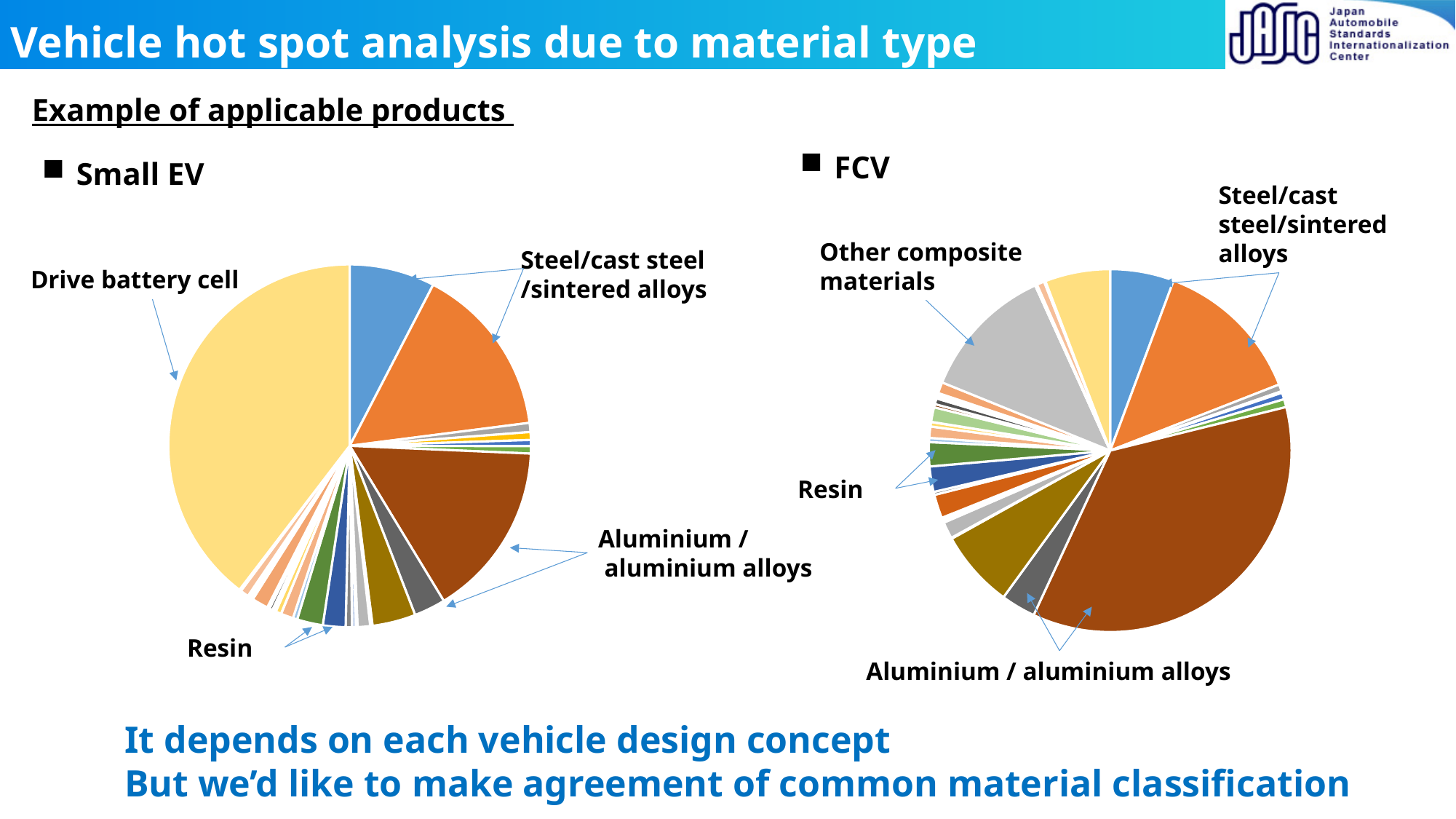
In the Small EV chart, which labelled material has the largest slice? Drive battery cell In the Small EV chart, which slice is larger: Aluminium / aluminium alloys or Resin? Aluminium / aluminium alloys In the FCV chart, which slice is larger: Aluminium / aluminium alloys or Steel/cast steel/sintered alloys? Aluminium / aluminium alloys In the FCV chart, which labelled material has the largest slice? Aluminium / aluminium alloys What kind of chart is the Small EV chart? Pie chart Which chart on the slide has a slice labelled Drive battery cell? Small EV What kind of chart is the FCV chart? Pie chart Which chart on the slide has a slice labelled Other composite materials? FCV In the Small EV chart, which slice is larger: Drive battery cell or Steel/cast steel/sintered alloys? Drive battery cell How many pie charts are shown on the slide? 2